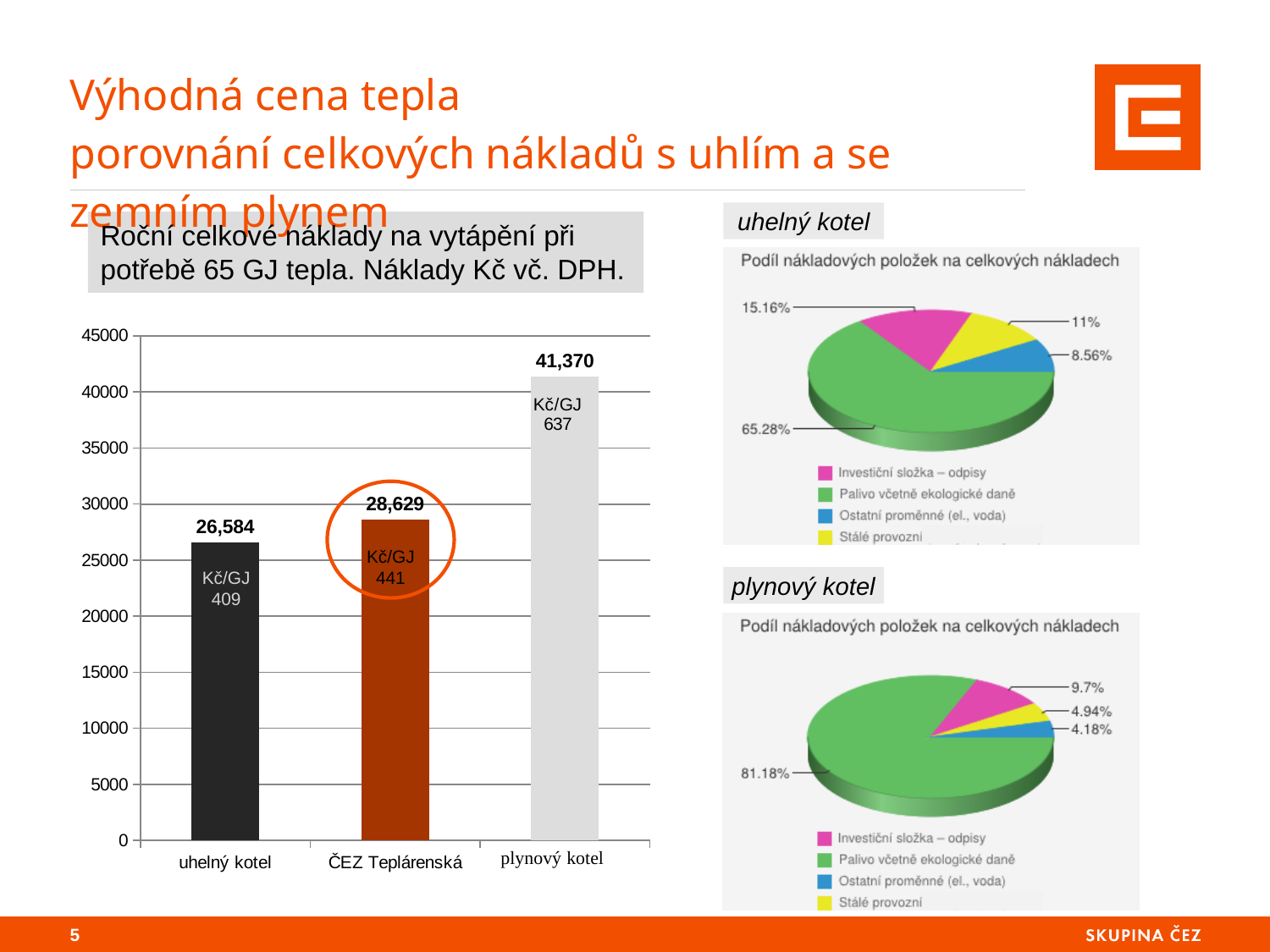
In the bar chart on the left, what is the difference between the annual cost for plynový kotel and for uhelný kotel? 14,786 In the bar chart on the left, which category has the highest annual cost? plynový kotel In the uhelný kotel pie chart, what share is Investiční složka – odpisy? 15.16% In the bar chart on the left, what is the annual cost for ČEZ Teplárenská? 28,629 In the plynový kotel pie chart, what share is Palivo včetně ekologické daně? 81.18% In the bar chart on the left, what is the Kč/GJ value shown inside the ČEZ Teplárenská bar? 441 In the uhelný kotel pie chart, what share is Palivo včetně ekologické daně? 65.28% In the plynový kotel pie chart, how many entries does the legend list? 4 In the bar chart on the left, what is the annual cost for plynový kotel? 41,370 In the bar chart on the left, which category has the lowest annual cost? uhelný kotel What kind of chart is the chart on the left of the slide? bar chart In the bar chart on the left, how many categories are shown on the x axis? 3